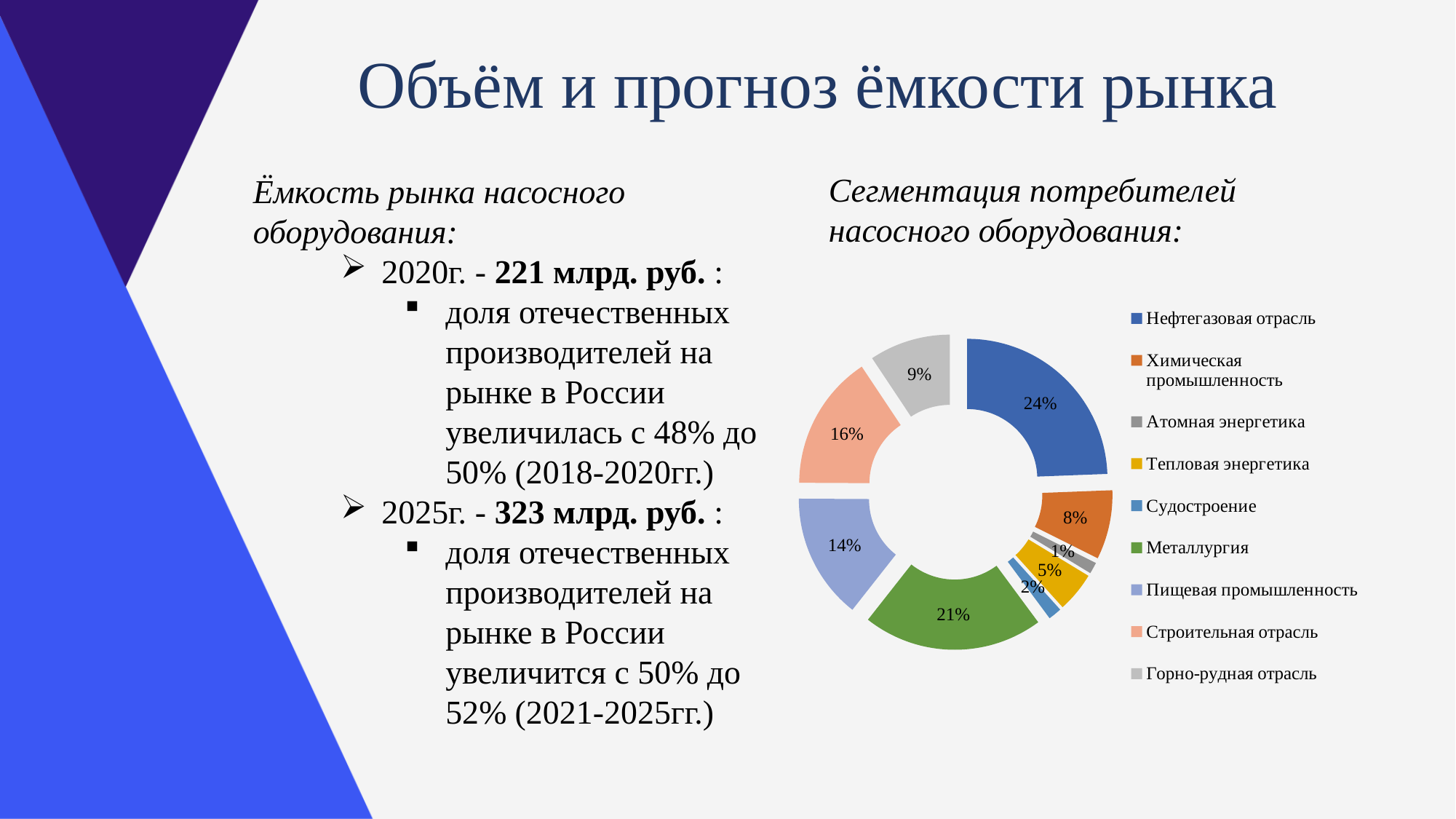
What is the difference between the shares of Нефтегазовая отрасль and Химическая промышленность? 16% What share of the chart does Нефтегазовая отрасль have? 24% Which category has the smallest share in the chart? Атомная энергетика What share of the chart does Пищевая промышленность have? 14% What share of the chart does Атомная энергетика have? 1% What kind of chart is shown on the slide? Doughnut (pie) chart What share of the chart does Строительная отрасль have? 16% What is the title text above the chart? Сегментация потребителей насосного оборудования: What share of the chart does Металлургия have? 21% How many categories does the legend of the chart list? 9 Which has a larger share, Тепловая энергетика or Судостроение? Тепловая энергетика Which category has the largest share in the chart? Нефтегазовая отрасль